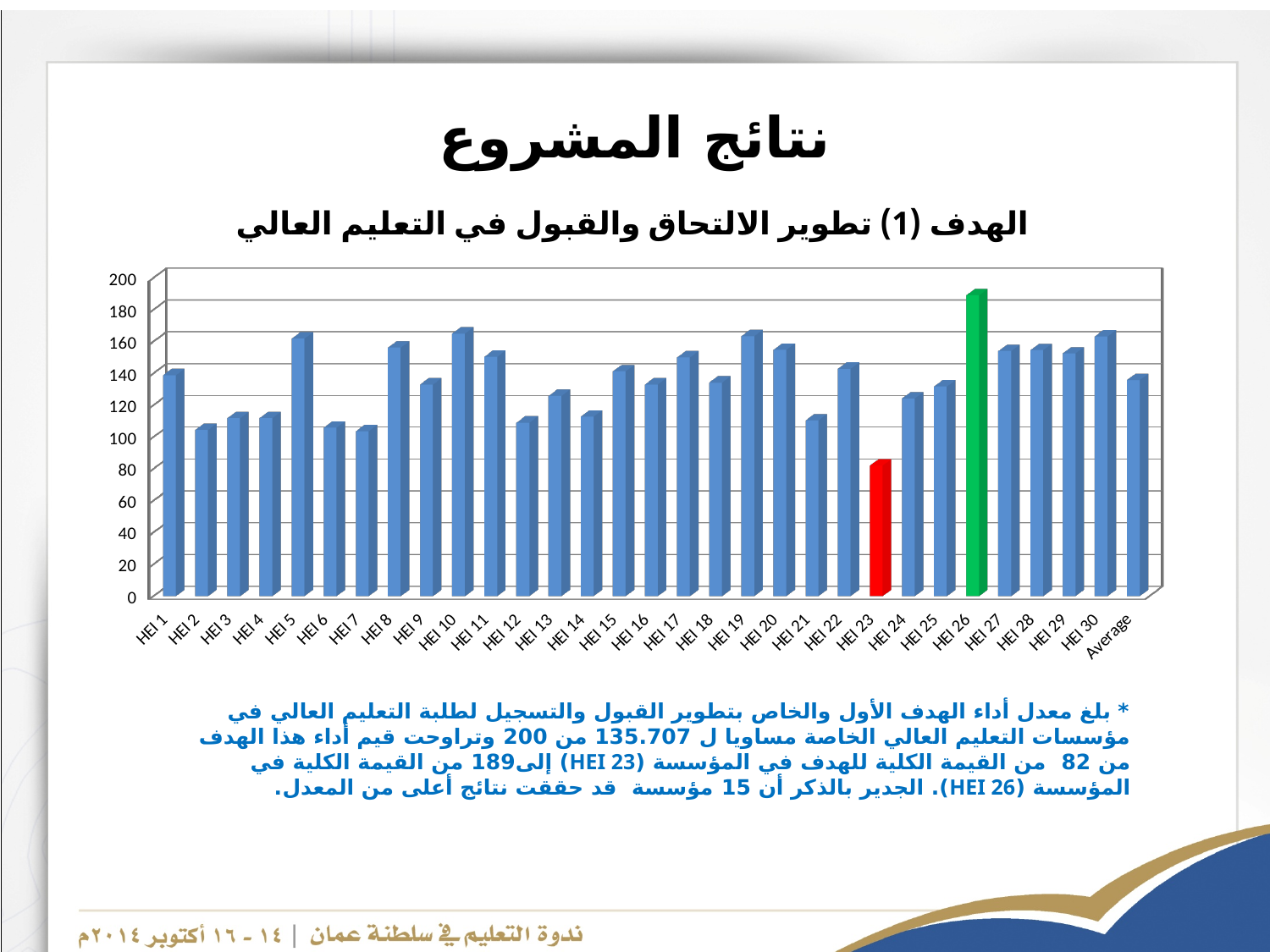
Which category has the highest bar on the chart? HEI 26 What colour is the bar for HEI 23? red How many bars (categories) are plotted on the chart? 31 Which is larger, the value for HEI 19 or the value for HEI 21? HEI 19 Is the value for HEI 5 greater or less than 140? greater Which category has the lowest bar on the chart? HEI 23 What kind of chart is shown on the slide? bar chart Is the value for HEI 2 greater or less than 120? less According to the slide, what is the value for HEI 23? 82 According to the slide, what is the Average value? 135.707 According to the slide, what is the value for HEI 26? 189 What is the difference between the values for HEI 26 and HEI 23? 107